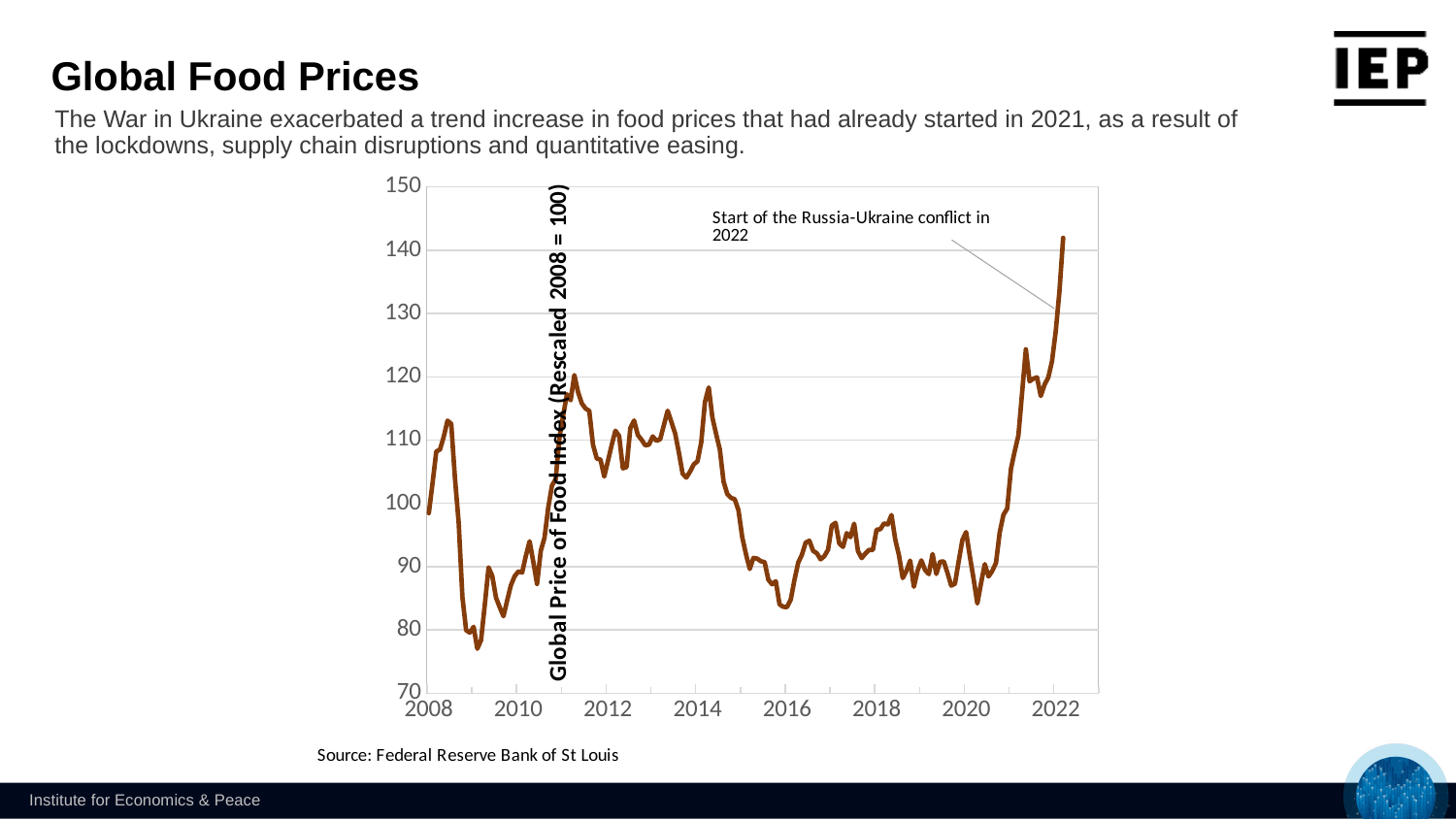
What kind of chart is shown on the slide? line chart How many lines are plotted on the chart? 1 Is the lowest point of the line before or after 2010? before What event does the annotation on the chart point to? Start of the Russia-Ukraine conflict in 2022 Does the food price index rise or fall between 2020 and 2022? rise Is the lowest value of the index in 2009 greater or less than 90? less Does the food price index rise or fall between 2014 and 2016? fall In which year does the line reach its highest value? 2022 Is the value of the index at the end of the line in 2022 greater or less than 130? greater Is the peak value of the index in 2011 greater or less than 110? greater What is the label of the y axis of the chart? Global Price of Food Index (Rescaled 2008 = 100)